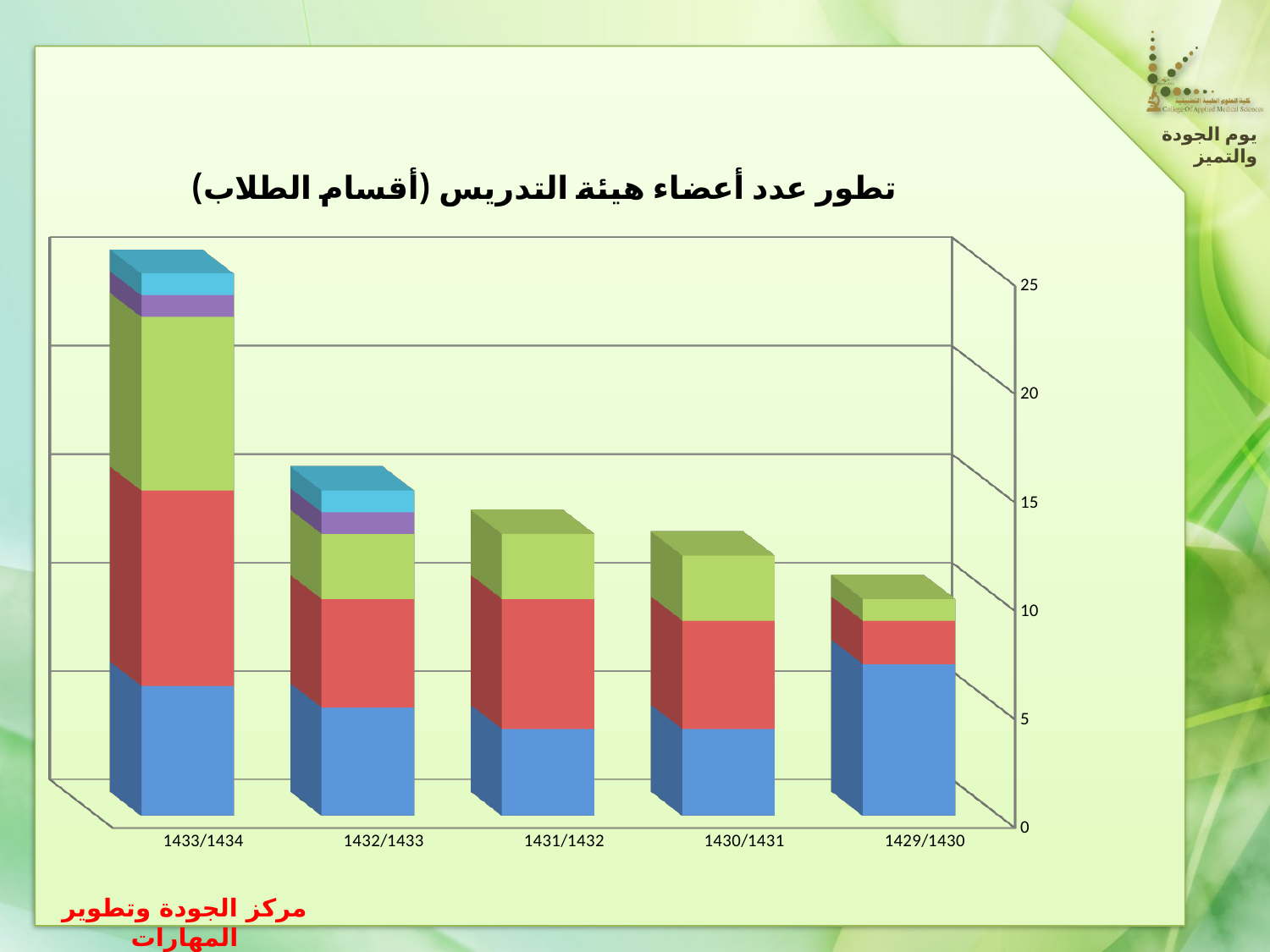
How many differently coloured segments make up the bar for 1433/1434? 5 Do the bar totals rise or fall moving from left (1433/1434) to right (1429/1430) along the x axis? fall Is the total for 1429/1430 greater or less than 15? less Is the total for 1430/1431 greater or less than 15? less Is the total for 1433/1434 greater or less than 20? greater Which has the taller stacked bar, 1432/1433 or 1431/1432? 1432/1433 How many academic years (categories) are shown on the x axis? 5 Which academic year has the shortest stacked bar? 1429/1430 What kind of chart is shown on the slide? Stacked bar chart Which academic year has the tallest stacked bar? 1433/1434 What is the title of the chart? تطور عدد أعضاء هيئة التدريس (أقسام الطلاب)